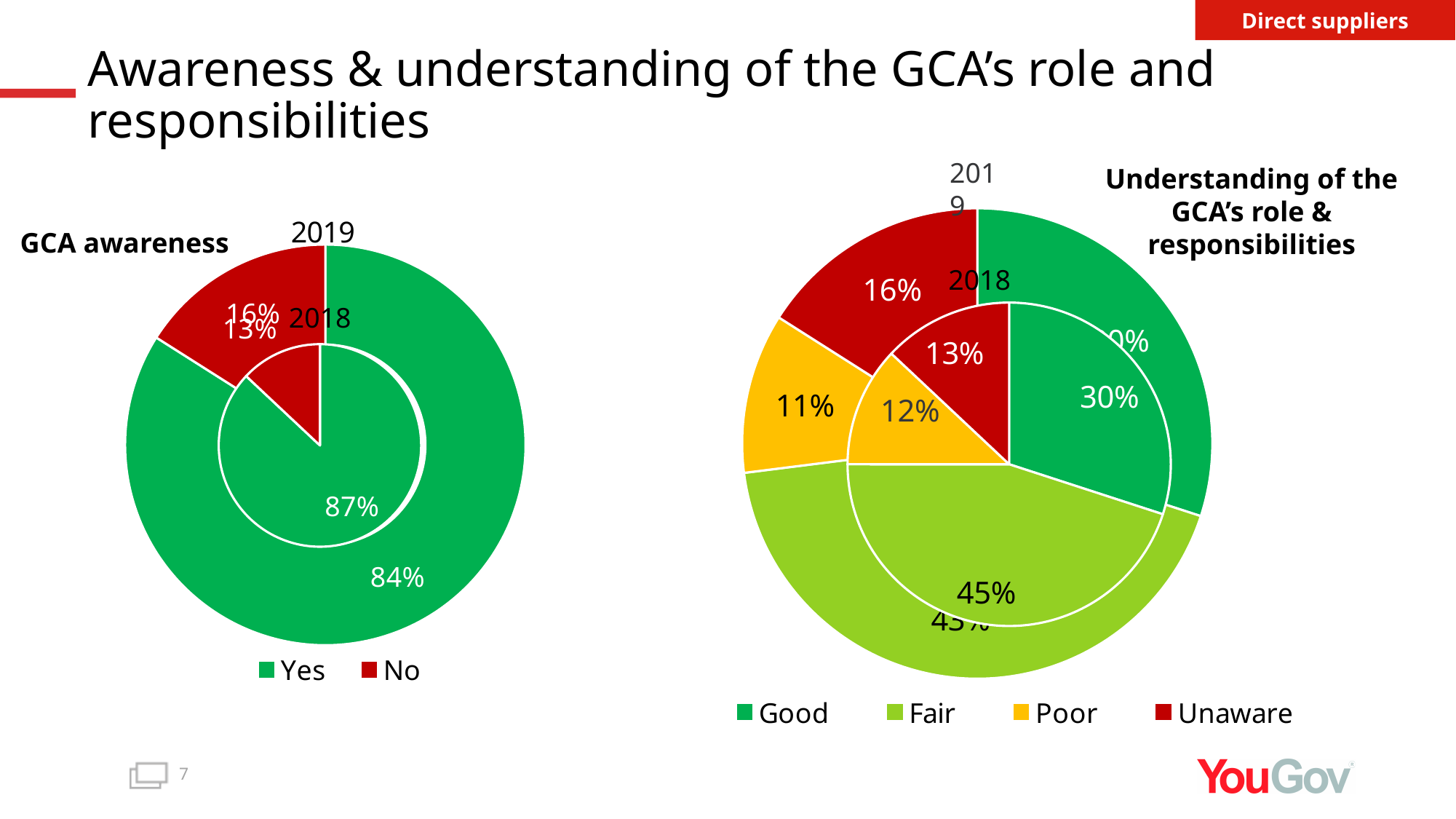
In the GCA awareness chart, what percentage answered No in 2018? 13% In the Understanding of the GCA's role & responsibilities chart, which category had the largest share in 2018? Fair In the GCA awareness chart, what percentage answered Yes in 2019? 84% In the GCA awareness chart, what percentage of direct suppliers answered Yes in 2018? 87% In the GCA awareness chart, what percentage answered No in 2019? 16% In the Understanding of the GCA's role & responsibilities chart, what share rated their understanding as Good in 2018? 30% In the Understanding of the GCA's role & responsibilities chart, what share were Unaware in 2019? 16% In the GCA awareness chart, by how many percentage points did the Yes share fall from 2018 to 2019? 3 percentage points In the Understanding of the GCA's role & responsibilities chart, what share rated their understanding as Poor in 2019? 11% In the Understanding of the GCA's role & responsibilities chart, what share rated their understanding as Fair in 2018? 45% How many categories does the legend of the Understanding of the GCA's role & responsibilities chart list? 4 In the Understanding of the GCA's role & responsibilities chart, was the Unaware share larger in 2018 or 2019? 2019